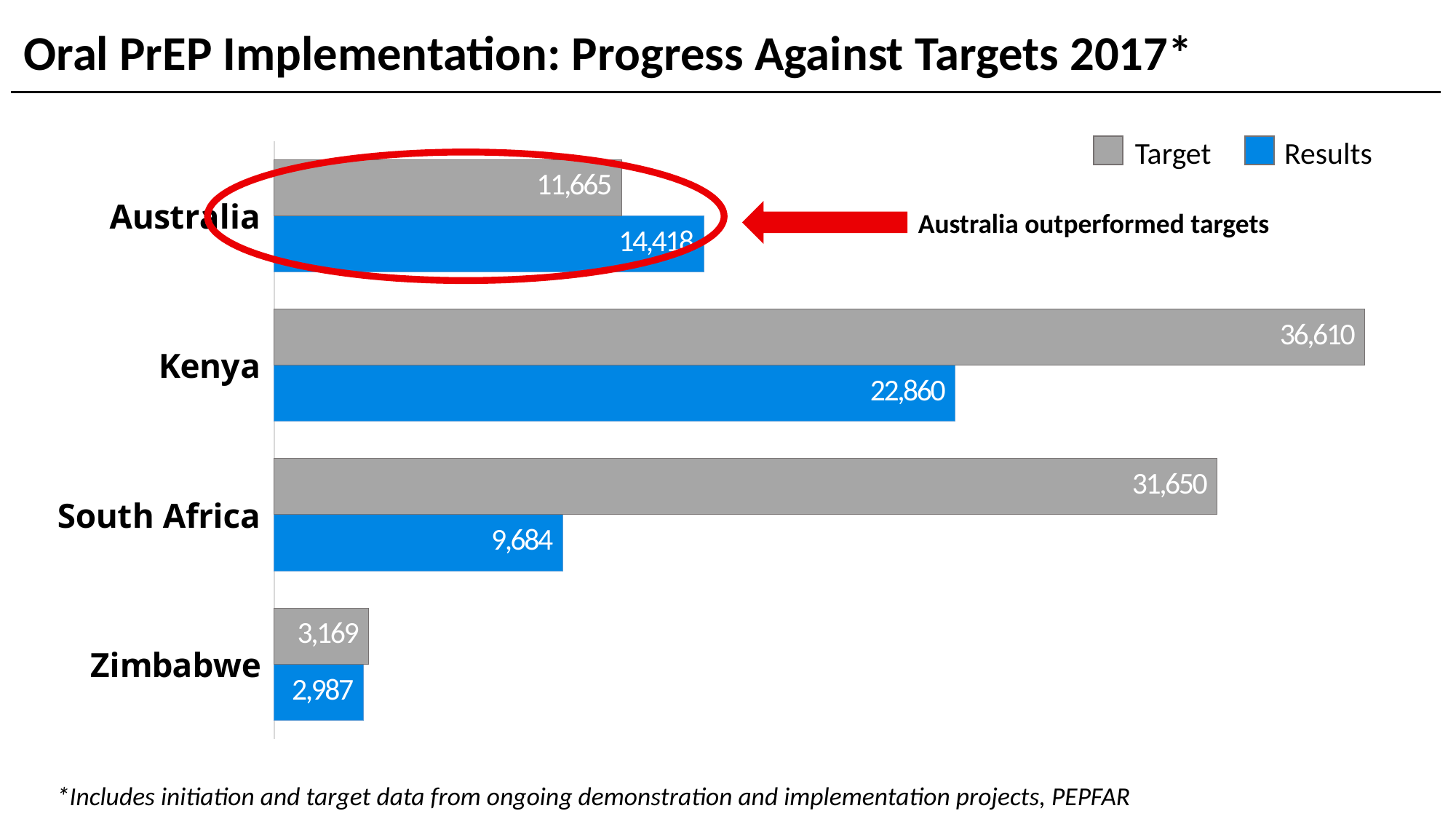
What is the Results value for South Africa? 9,684 What is the difference between the Results and Target values for Australia? 2,753 How many countries are shown on the chart? 4 What is the Target value for Kenya? 36,610 Which country has the highest Target value? Kenya Which is larger for South Africa, the Target or the Results value? Target How many series does the legend list? 2 What is the Target value for Zimbabwe? 3,169 What kind of chart is shown on the slide? Bar chart What is the difference between the Target and Results values for Kenya? 13,750 Which country has the lowest Results value? Zimbabwe What is the Results value for Australia? 14,418